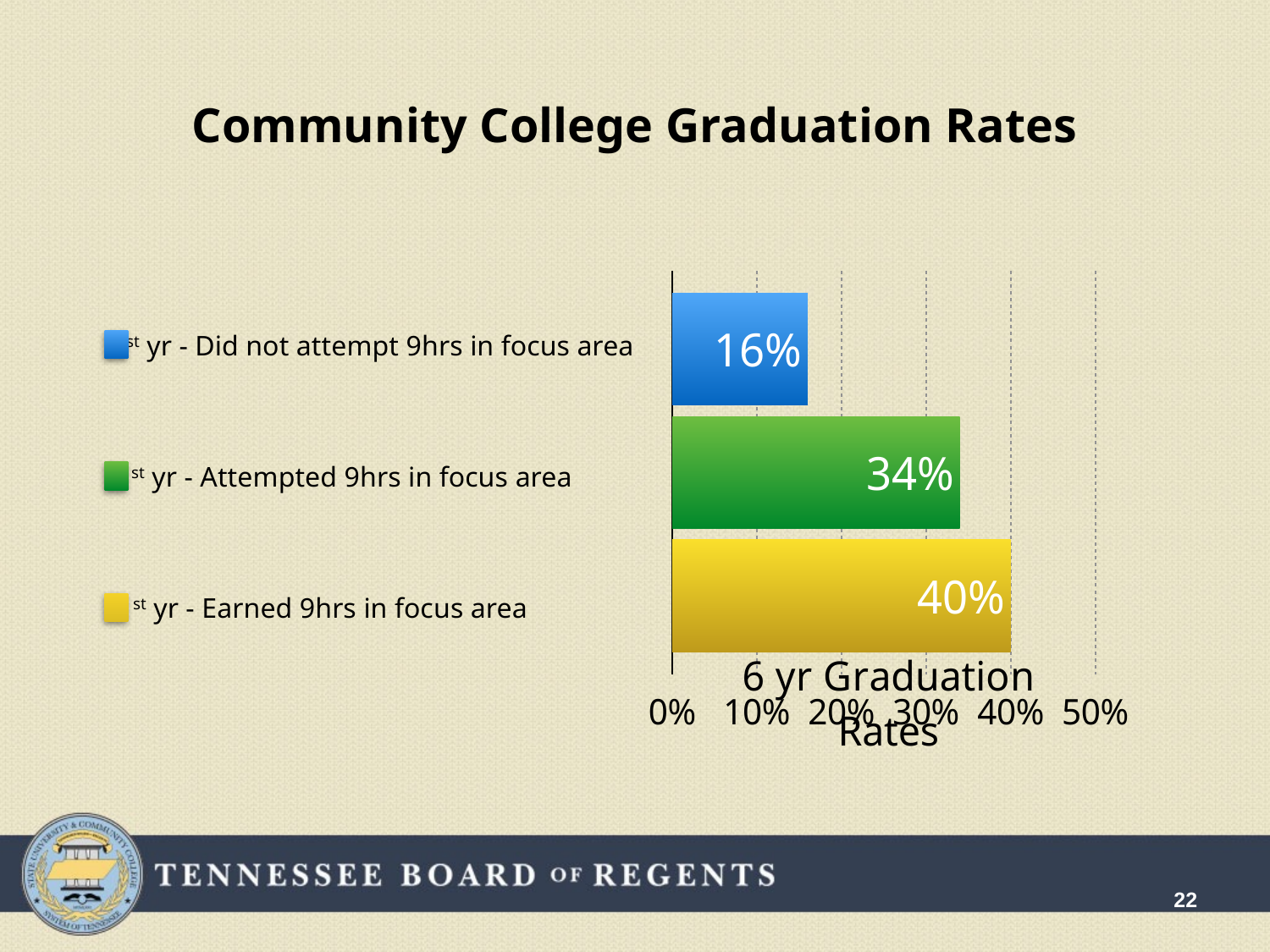
What is the 6 yr graduation rate for students who earned 9hrs in focus area in the 1st year? 40% What kind of chart is shown on the slide? Bar chart How many series does the legend list? 3 Which group has the lowest 6 yr graduation rate? 1st yr - Did not attempt 9hrs in focus area Is the graduation rate for students who attempted 9hrs in focus area greater or less than 30%? greater Which group has the highest 6 yr graduation rate? 1st yr - Earned 9hrs in focus area What is the 6 yr graduation rate for students who did not attempt 9hrs in focus area in the 1st year? 16% What is the difference in 6 yr graduation rate between students who earned 9hrs and those who attempted 9hrs in focus area? 6% What is the difference in 6 yr graduation rate between students who earned 9hrs in focus area and those who did not attempt 9hrs? 24% What colour is the bar for students who earned 9hrs in focus area? Yellow Which is larger: the graduation rate for students who attempted 9hrs in focus area or for those who did not attempt 9hrs? Attempted 9hrs in focus area What is the 6 yr graduation rate for students who attempted 9hrs in focus area in the 1st year? 34%